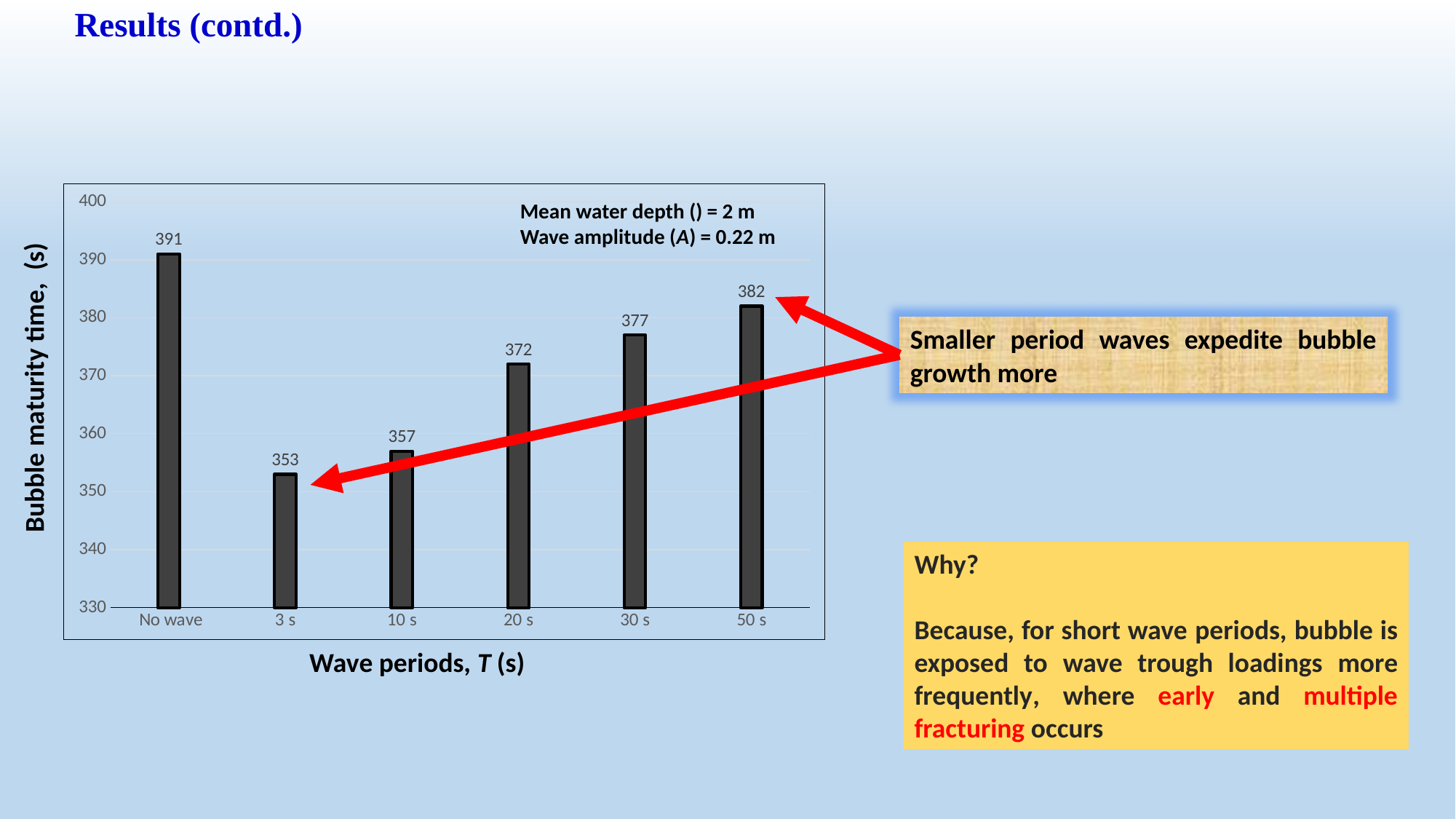
What is the label of the y axis of the chart? Bubble maturity time, (s) What is the difference in bubble maturity time between the 'No wave' case and the 3 s wave period? 38 How many categories are shown on the x axis of the chart? 6 What kind of chart is shown on the slide? Bar chart What is the bubble maturity time for the 'No wave' case? 391 Which has a larger bubble maturity time, the 10 s or the 30 s wave period? 30 s Which category has the highest bubble maturity time? No wave What is the difference in bubble maturity time between the 50 s and 30 s wave periods? 5 What is the bubble maturity time for a wave period of 3 s? 353 What is the bubble maturity time for a wave period of 20 s? 372 Which wave period has the lowest bubble maturity time? 3 s From the 3 s wave period to the 50 s wave period, does the bubble maturity time rise or fall? Rise